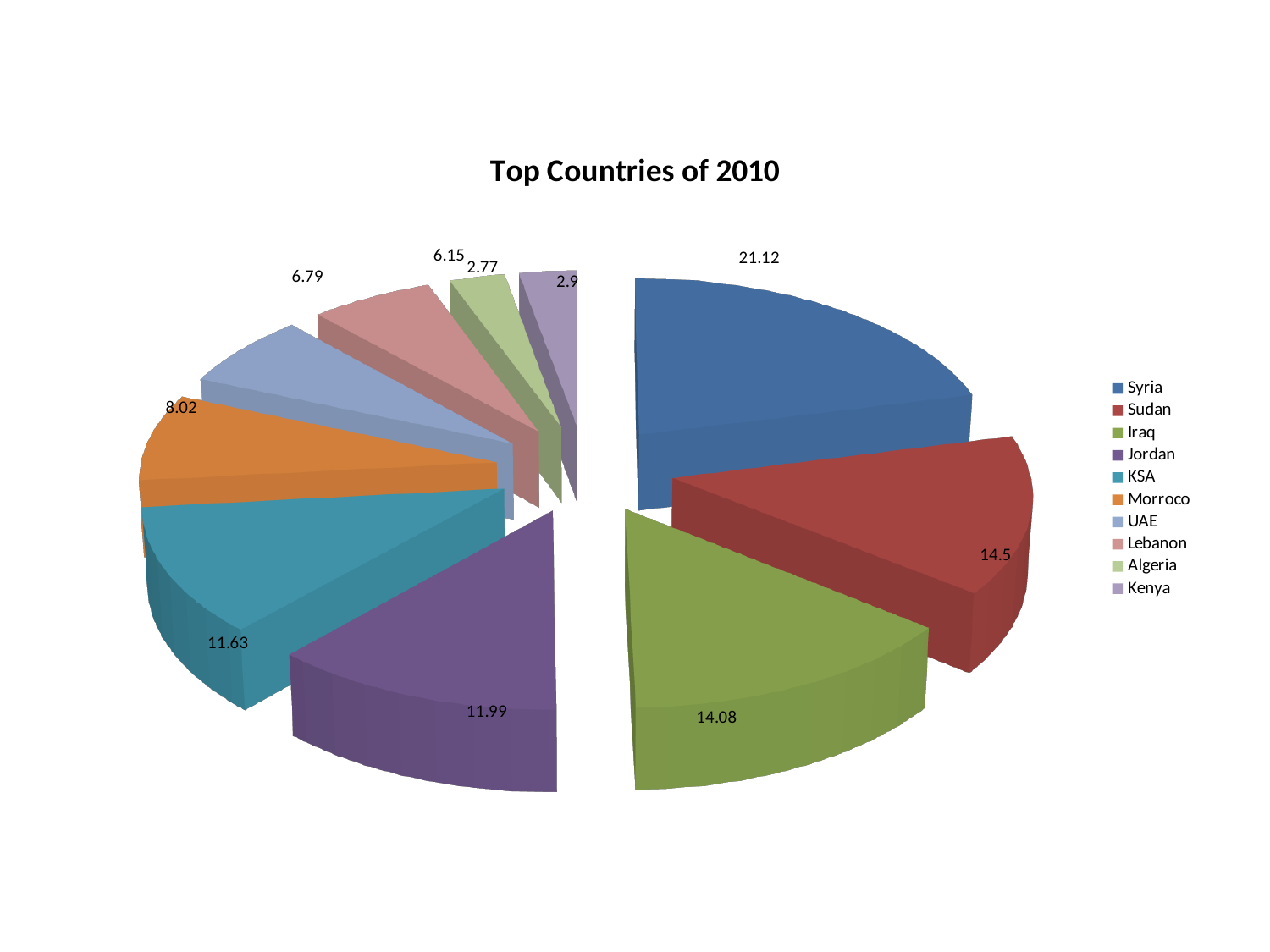
What is the value for Jordan? 11.99 What is the difference between the values for Syria and Sudan? 6.62 How many countries are shown in the pie chart? 10 What type of chart is shown on the slide? Pie chart What is the title of the chart? Top Countries of 2010 What is the value for Morroco? 8.02 What is the value for Lebanon? 6.15 Which country has the largest slice? Syria Which country has the smallest slice? Algeria Which colour represents Kenya in the legend? Light purple Which is larger, the value for Iraq or the value for KSA? Iraq What is the value for Syria? 21.12